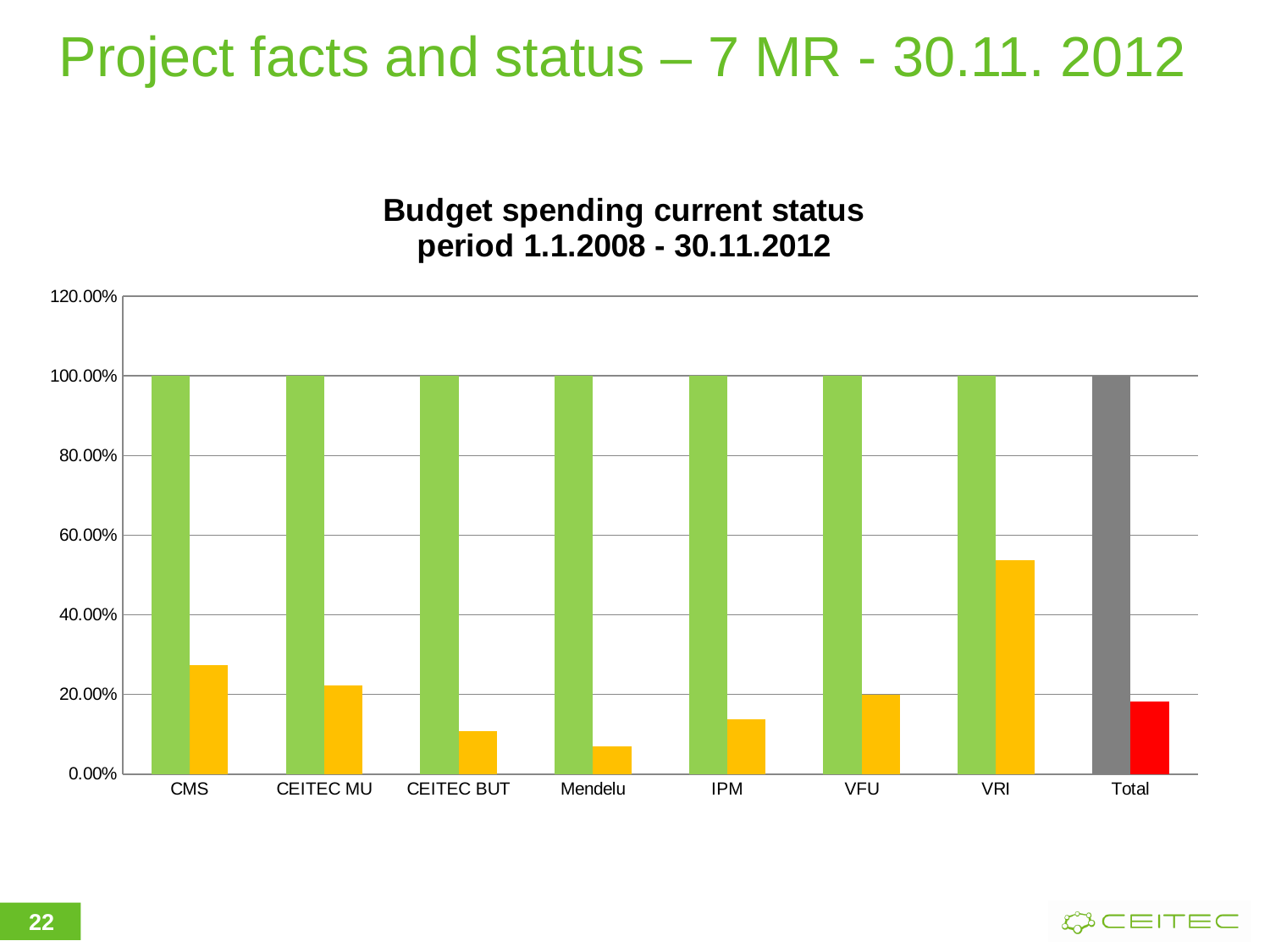
Is the orange bar for Mendelu greater or less than 20.00%? less Is the orange bar for CMS greater or less than 20.00%? greater Which category has the highest orange bar? VRI What colour is the second bar for the Total category? red What is the title of the chart? Budget spending current status period 1.1.2008 - 30.11.2012 What kind of chart is shown on the slide? bar chart How many categories are shown on the x axis of the chart? 8 What value does the grey bar for Total reach? 100.00% Which category has the lowest orange bar? Mendelu What value does the green bar for CMS reach? 100.00% Is the orange bar for VRI greater or less than 40.00%? greater Is the orange bar for CMS or the orange bar for CEITEC BUT taller? CMS